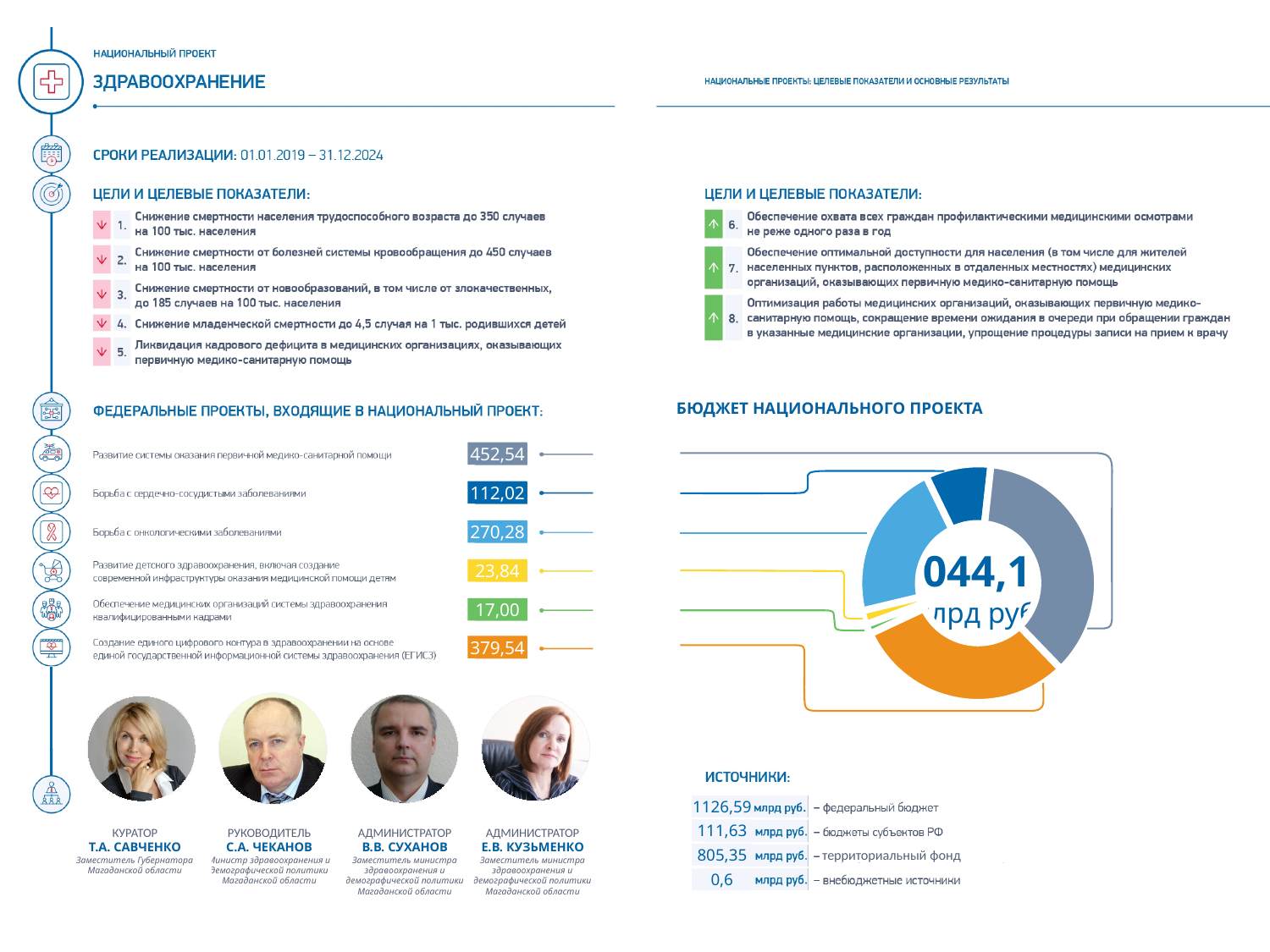
In the budget donut chart, which is larger: the value for 'Борьба с онкологическими заболеваниями' or for 'Борьба с сердечно-сосудистыми заболеваниями'? Борьба с онкологическими заболеваниями In the budget donut chart, what is the value for 'Борьба с сердечно-сосудистыми заболеваниями'? 112,02 In the budget donut chart, what is the difference between the values for 'Развитие системы оказания первичной медико-санитарной помощи' (452,54) and 'Создание единого цифрового контура в здравоохранении' (379,54)? 73,00 In the budget donut chart, what is the value for 'Борьба с онкологическими заболеваниями'? 270,28 In the budget donut chart, what is the value for 'Обеспечение медицинских организаций системы здравоохранения квалифицированными кадрами'? 17,00 What kind of chart is shown under the heading 'БЮДЖЕТ НАЦИОНАЛЬНОГО ПРОЕКТА'? Pie (donut) chart Which federal project has the smallest value in the budget donut chart? Обеспечение медицинских организаций системы здравоохранения квалифицированными кадрами What colour is the slice for 'Развитие детского здравоохранения' in the budget donut chart? Yellow In the budget donut chart, what is the value for 'Создание единого цифрового контура в здравоохранении на основе единой государственной информационной системы здравоохранения (ЕГИСЗ)'? 379,54 Which federal project has the largest value in the budget donut chart? Развитие системы оказания первичной медико-санитарной помощи How many federal projects (slices) are shown in the budget donut chart? 6 In the budget donut chart, what is the value for 'Развитие системы оказания первичной медико-санитарной помощи'? 452,54